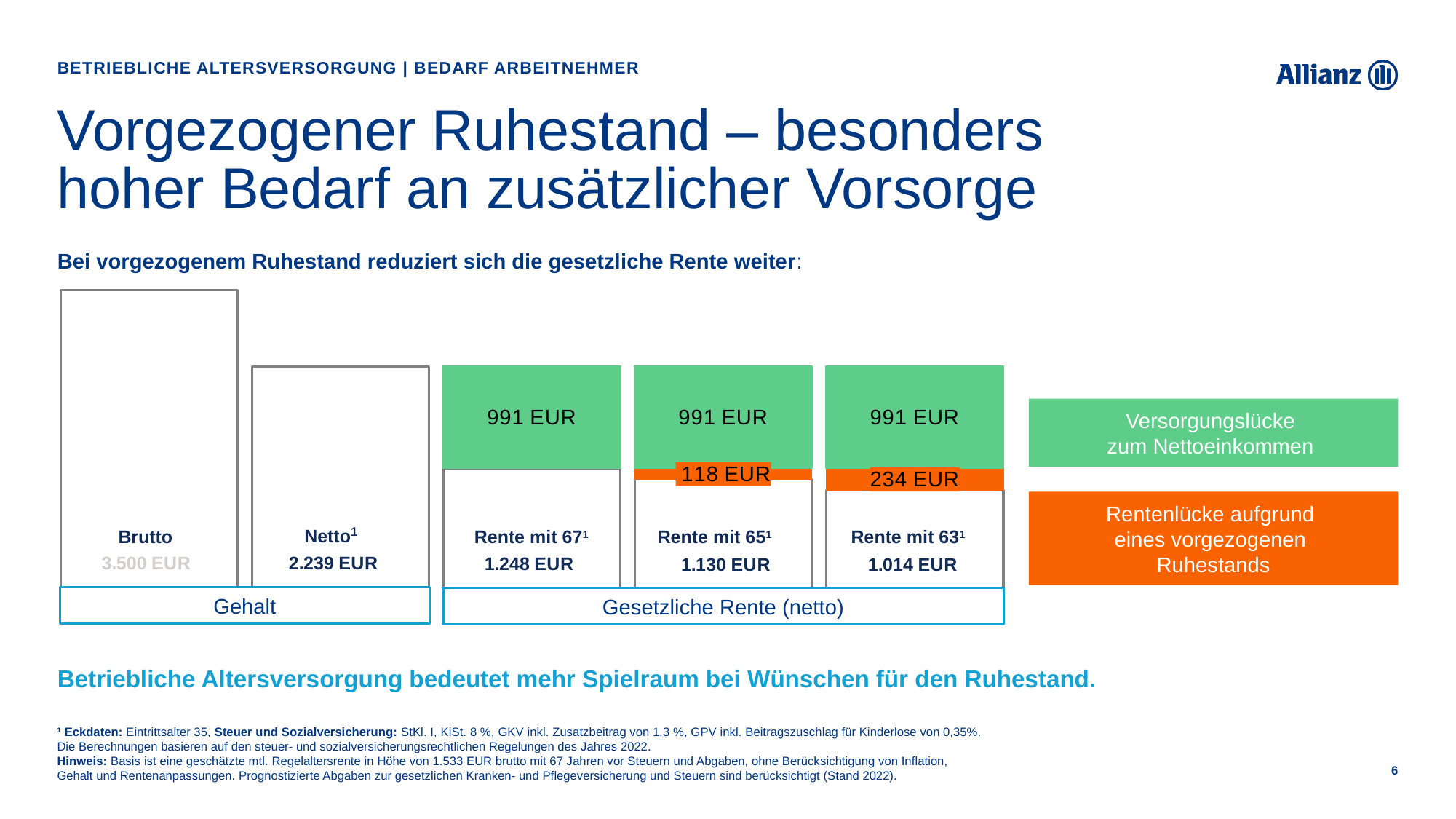
What is the value shown for Netto? 2.239 EUR What is the orange Rentenlücke value shown for Rente mit 63? 234 EUR What is the difference between the Rente mit 67 value and the Rente mit 65 value? 118 EUR What is the value shown for Brutto? 3.500 EUR What does the green colour in the chart represent? Versorgungslücke zum Nettoeinkommen What is the difference between the Netto value and the Rente mit 67 value? 991 EUR What is the orange Rentenlücke value shown for Rente mit 65? 118 EUR Which bar has the lowest value? Rente mit 63 Which bar has the highest value? Brutto What is the value shown for Rente mit 63? 1.014 EUR What is the value shown for Rente mit 67? 1.248 EUR Which is larger, the value for Rente mit 65 or the value for Rente mit 63? Rente mit 65